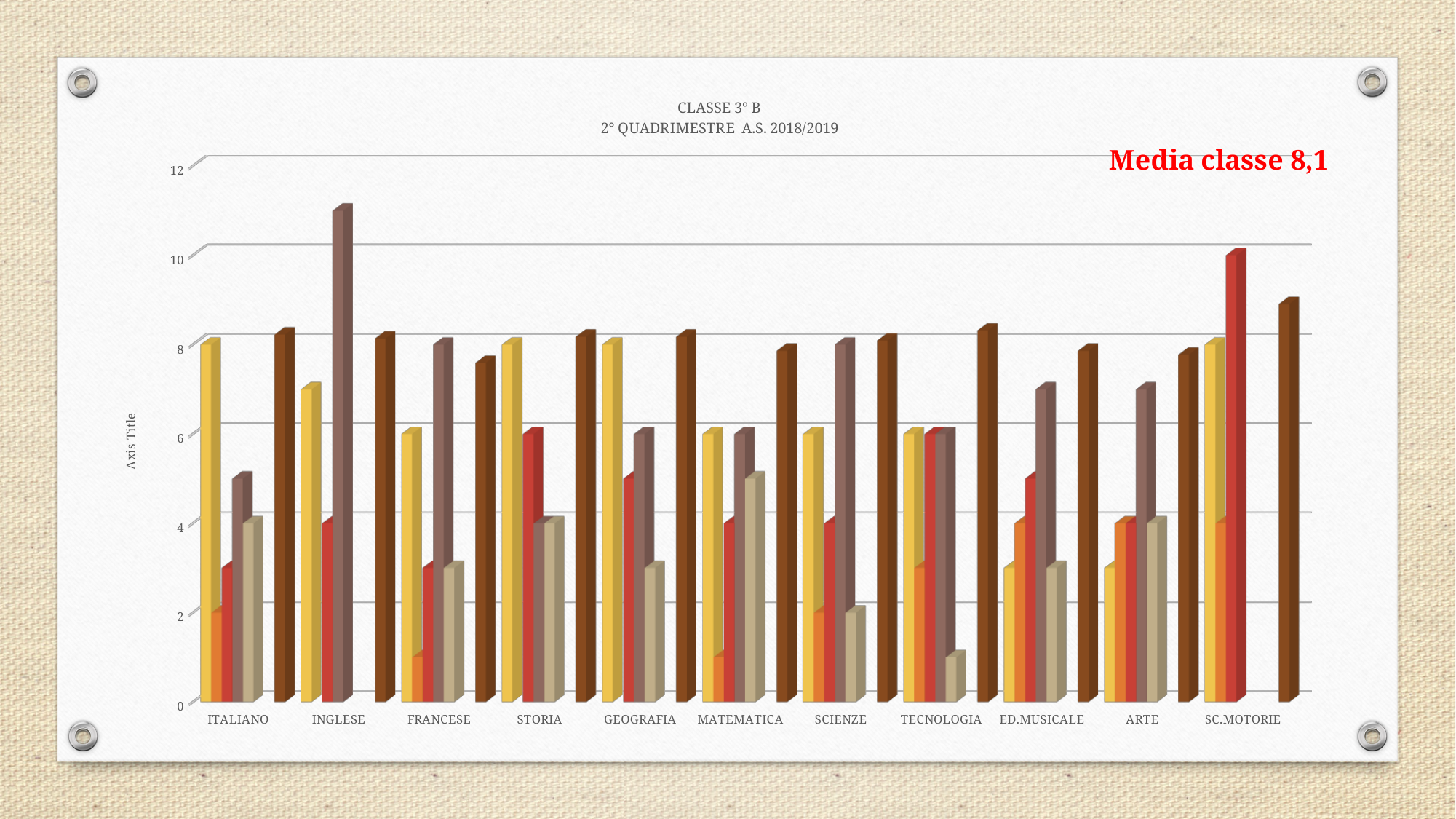
Is the value of the tallest bar in the INGLESE group greater or less than 10? greater How many subject categories are shown on the x axis of the chart? 11 Is the value of the tan (light brown) bar in the TECNOLOGIA group greater or less than 2? less Is the value of the mauve bar in the ITALIANO group greater or less than 6? less What class average (Media classe) is written in red on the slide? 8,1 What is the highest value shown on the vertical axis of the chart? 12 Which category contains the tallest bar on the chart? INGLESE What kind of chart is shown on the slide? bar chart